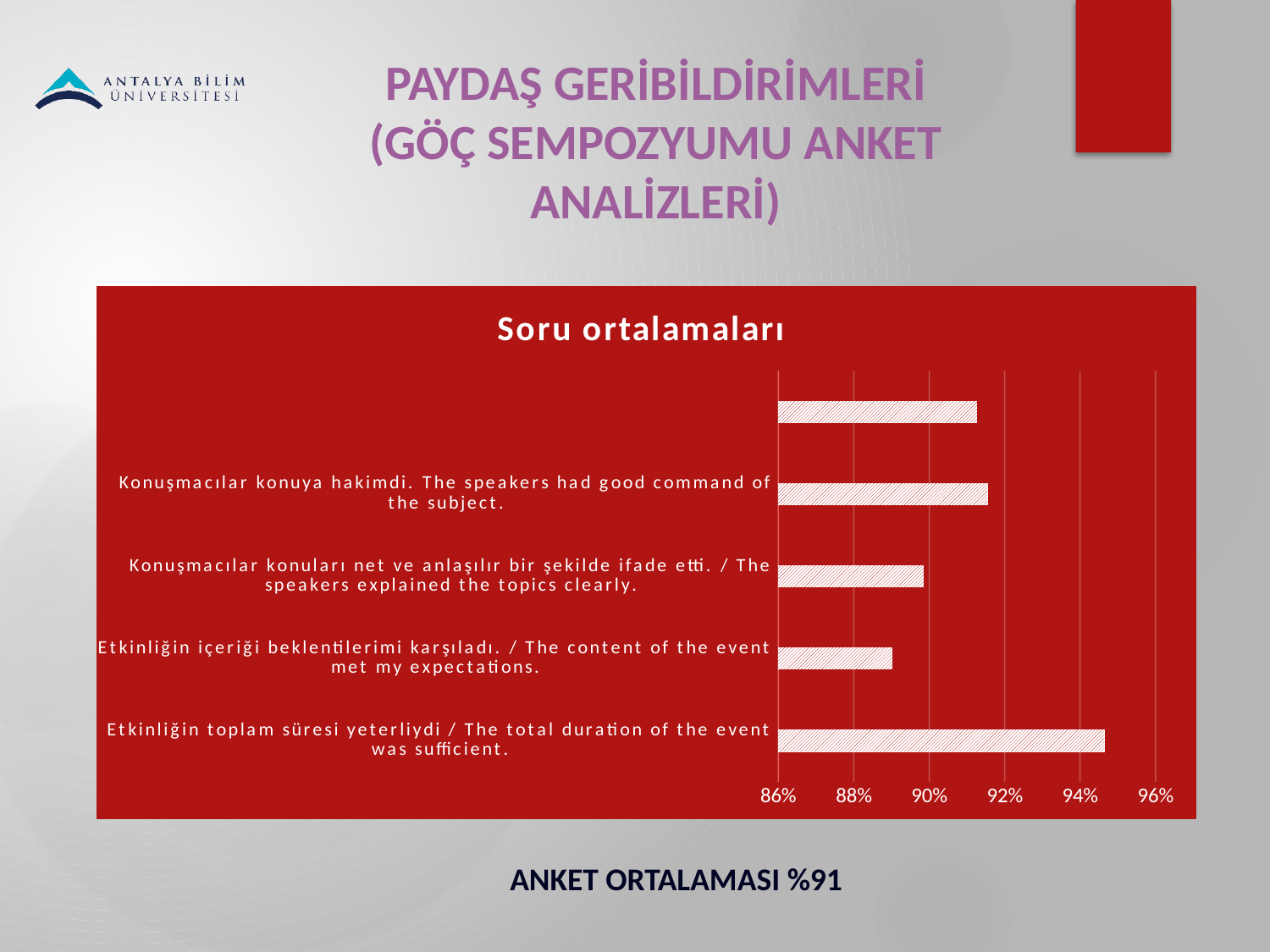
Which is larger: the value for 'Konuşmacılar konuya hakimdi' or for 'Konuşmacılar konuları net ve anlaşılır bir şekilde ifade etti'? Konuşmacılar konuya hakimdi Which labelled category has the lowest value in the chart? Etkinliğin içeriği beklentilerimi karşıladı. / The content of the event met my expectations. Which is larger: the value for 'Etkinliğin toplam süresi yeterliydi' or for 'Etkinliğin içeriği beklentilerimi karşıladı'? Etkinliğin toplam süresi yeterliydi Is the value for 'Konuşmacılar konuya hakimdi' greater or less than 90%? greater What kind of chart is shown on the slide? bar chart Which category has the highest value in the chart? Etkinliğin toplam süresi yeterliydi / The total duration of the event was sufficient. Is the value for 'Etkinliğin toplam süresi yeterliydi' greater or less than 94%? greater How many bars are plotted in the chart? 5 Is the value for 'Etkinliğin içeriği beklentilerimi karşıladı' greater or less than 90%? less What are the lowest and highest tick values shown on the chart's value axis? 86% and 96% What is the title of the chart? Soru ortalamaları